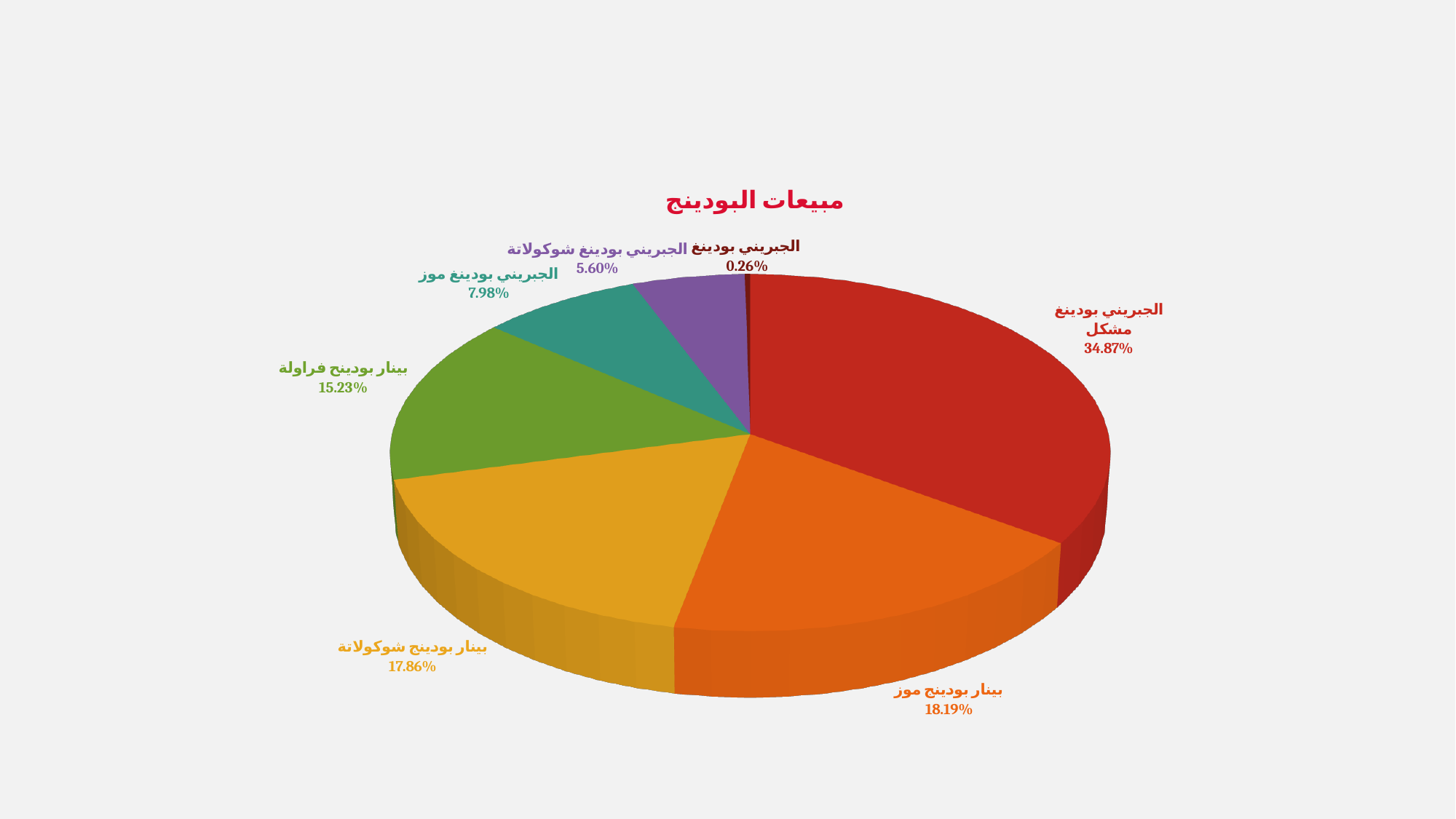
What share of the pie does الجبريني بودينغ مشكل have? 34.87% Which category has the smallest share of the pie? الجبريني بودينغ What share of the pie does بينار بودينج موز have? 18.19% What type of chart is shown on the slide? Pie chart What share of the pie does الجبريني بودينغ موز have? 7.98% How many categories (slices) does the pie chart have? 7 Which category has the largest share of the pie? الجبريني بودينغ مشكل What is the title of the chart? مبيعات البودينج Which has a larger share, الجبريني بودينغ موز or الجبريني بودينغ شوكولاتة? الجبريني بودينغ موز What share of the pie does بينار بودينج شوكولاتة have? 17.86% What share of the pie does بينار بودينج فراولة have? 15.23% What is the difference in share between الجبريني بودينغ مشكل and بينار بودينج موز? 16.68%